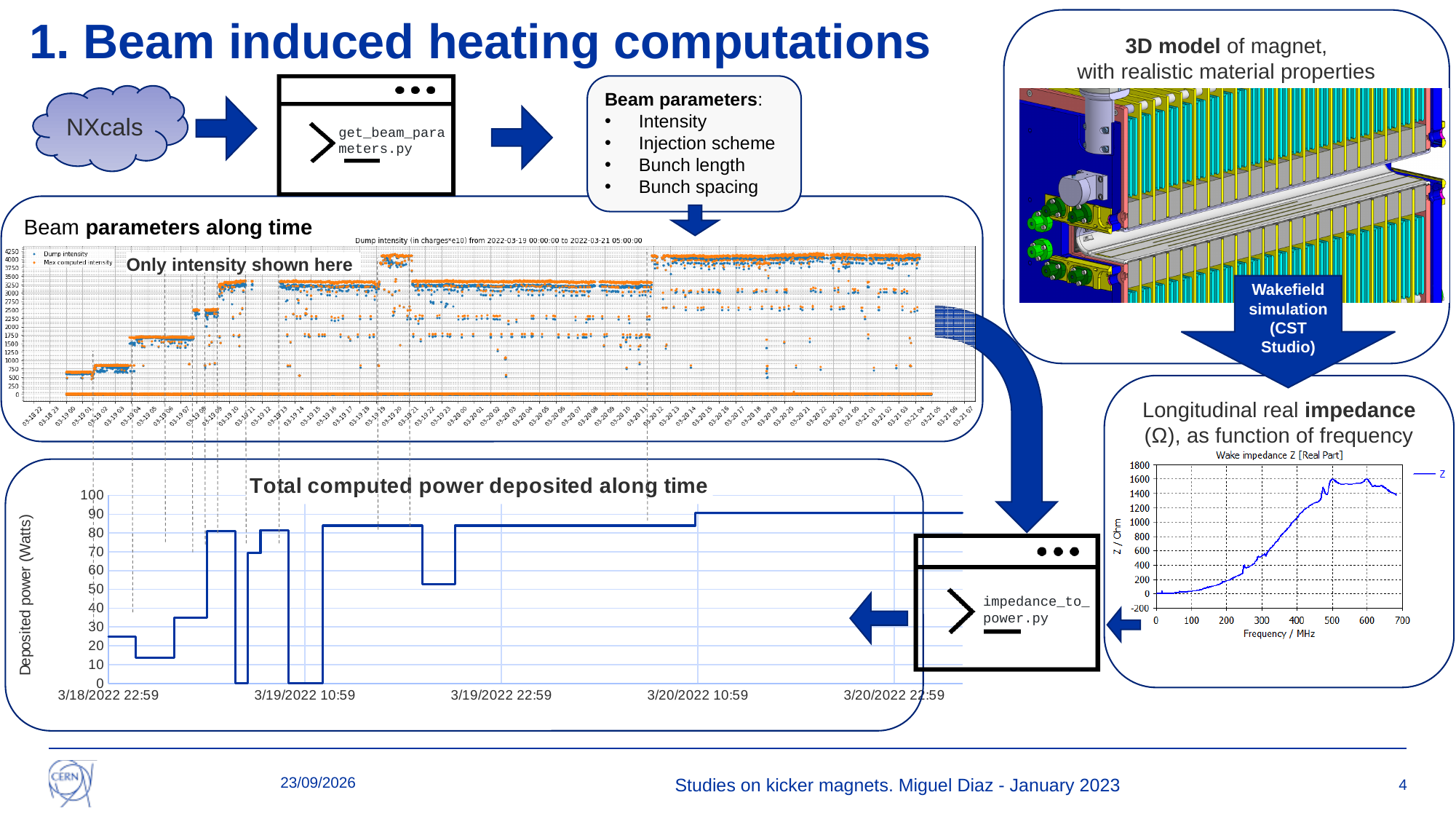
In the 'Total computed power deposited along time' chart, does the deposited power overall rise or fall from 3/18/2022 22:59 to 3/20/2022 22:59? rise In the 'Total computed power deposited along time' chart, is the deposited power at 3/20/2022 22:59 greater or less than 80? greater In the 'Wake impedance Z [Real Part]' chart, does the impedance rise or fall as frequency increases from 0 to 500 MHz? rise In the 'Total computed power deposited along time' chart, how many date labels are shown on the x axis? 5 In the 'Total computed power deposited along time' chart, what is the label of the y axis? Deposited power (Watts) In the 'Wake impedance Z [Real Part]' chart, is the impedance at 300 MHz greater or less than 800? less In the 'Wake impedance Z [Real Part]' chart, is the impedance at 600 MHz greater or less than 1400? greater What type of chart is the 'Total computed power deposited along time' chart? line chart In the 'Total computed power deposited along time' chart, what is the highest value shown on the y axis? 100 How many series does the legend of the 'Beam parameters along time' chart list? 2 What type of chart is the 'Wake impedance Z [Real Part]' chart? line chart